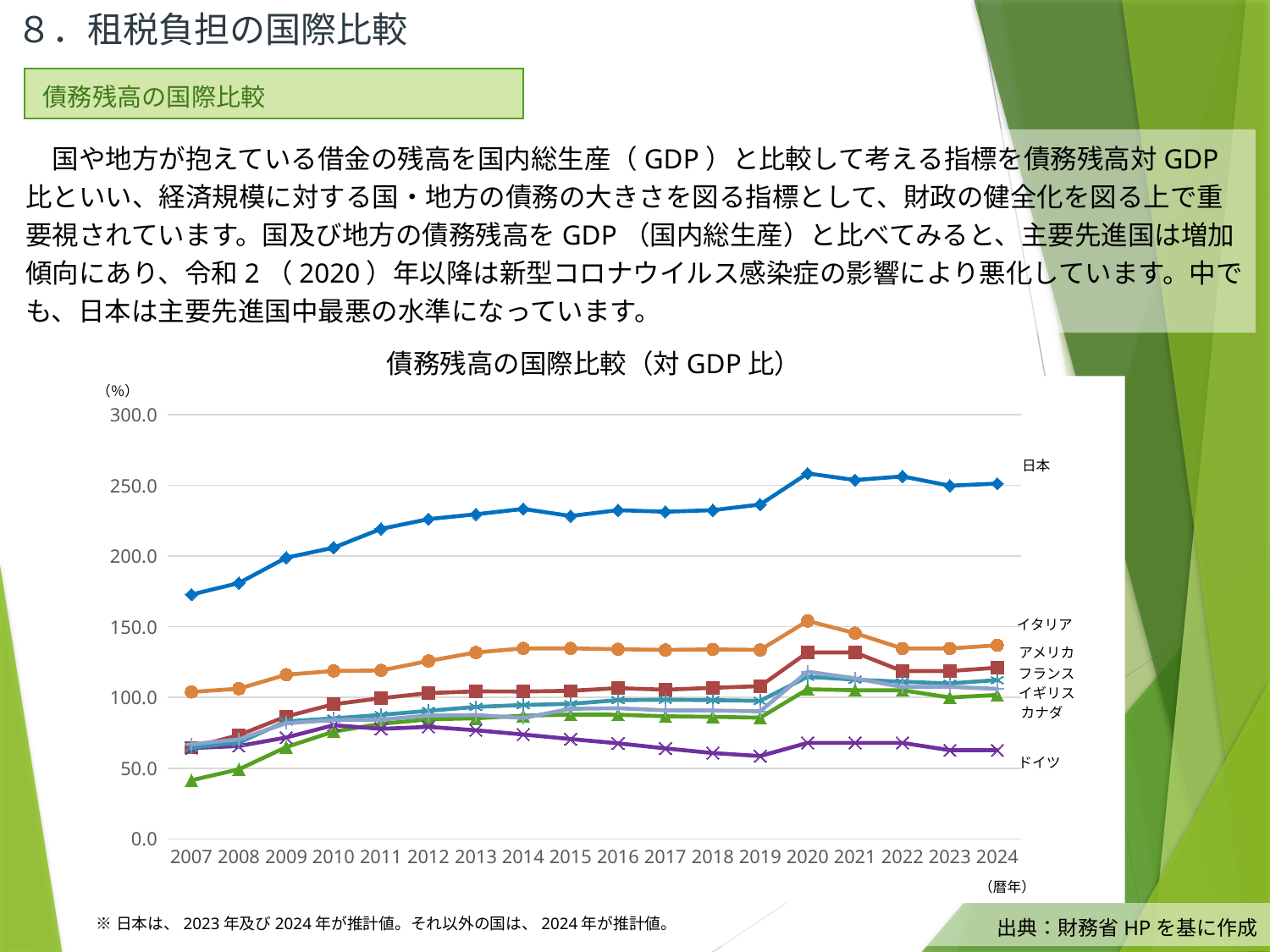
Is the value for 日本 in 2020 greater or less than 250? greater Which is larger in 2024, the value for 日本 or the value for イタリア? 日本 What kind of chart is shown on the slide? line chart How many years are shown on the x axis of the chart? 18 How many countries (series) are plotted in the chart? 7 Is the value for 日本 in 2007 greater or less than 150? greater Does the value for 日本 rise or fall overall from 2007 to 2024? rise What is the title of the chart? 債務残高の国際比較（対GDP比） Which country has the highest debt-to-GDP ratio in 2024? 日本 Which country has the lowest debt-to-GDP ratio in 2024? ドイツ